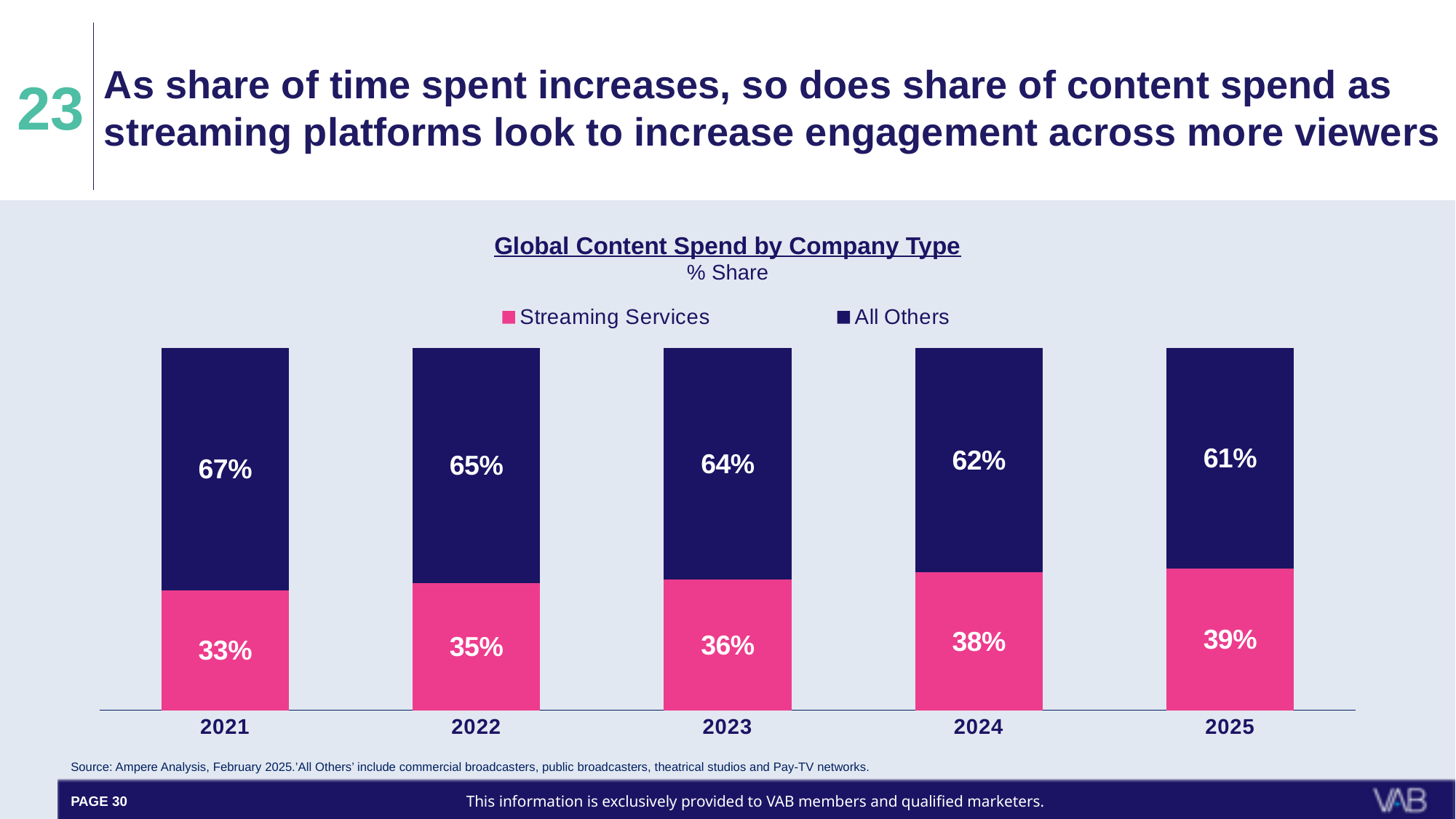
In which year is the All Others share lowest? 2025 Does the Streaming Services share rise or fall from 2021 to 2025? Rise What is the All Others share of global content spend in 2025? 61% How many series does the legend list? 2 What kind of chart is shown on the slide? Stacked bar chart In which year is the Streaming Services share highest? 2025 By how many percentage points did the Streaming Services share grow from 2021 to 2025? 6% What is the difference between the All Others share and the Streaming Services share in 2023? 28% What is the Streaming Services share of global content spend in 2021? 33% What is the Streaming Services share in 2024? 38% Which is larger in 2022, the Streaming Services share or the All Others share? All Others How many years are shown on the x axis? 5